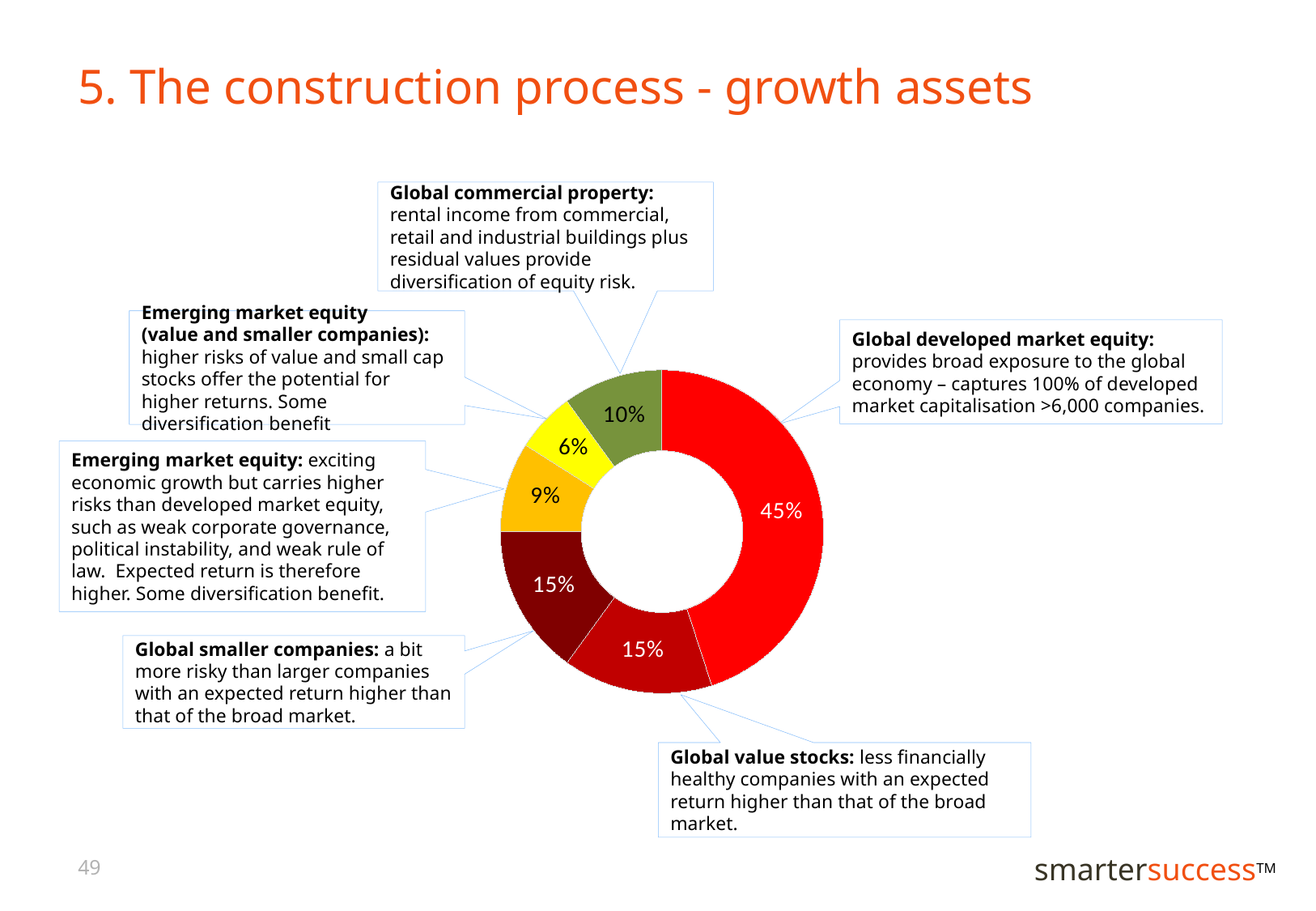
What share of the chart is Global developed market equity? 45% What share of the chart is Global commercial property? 10% Which is larger, the Emerging market equity slice or the Global commercial property slice? Global commercial property What share of the chart is Emerging market equity? 9% What share of the chart is Global value stocks? 15% What is the difference between the Global developed market equity share and the Global commercial property share? 35 percentage points How many slices does the chart have? 6 What kind of chart is shown on the slide? Donut (pie) chart What share of the chart is Emerging market equity (value and smaller companies)? 6% Which asset class has the smallest slice of the chart? Emerging market equity (value and smaller companies) What colour is the Global developed market equity slice? Red Which asset class has the largest slice of the chart? Global developed market equity